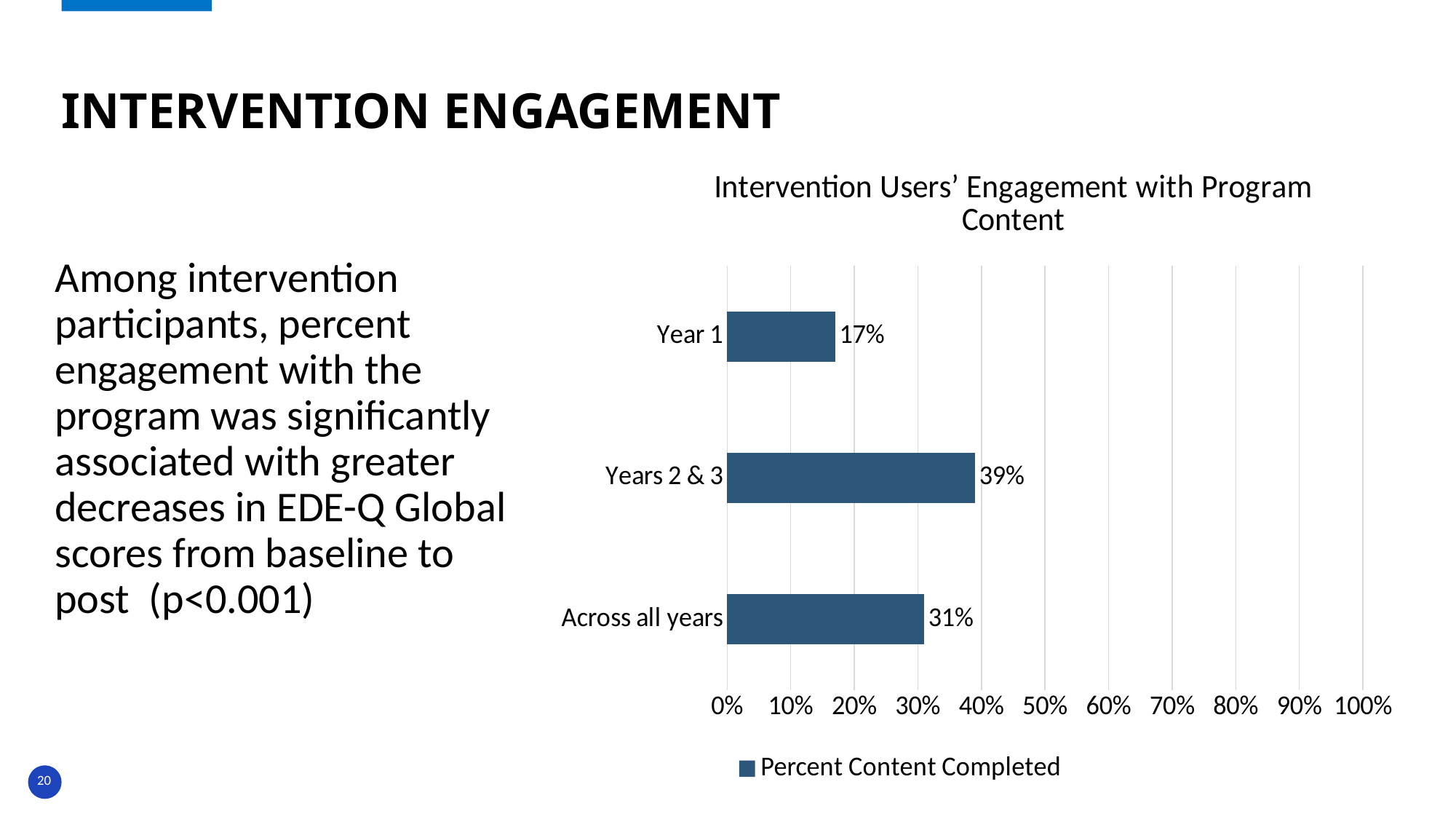
What is the Percent Content Completed for Years 2 & 3? 39% What kind of chart is shown on the slide? Bar chart What is the title of the chart? Intervention Users' Engagement with Program Content Which has a higher Percent Content Completed, Year 1 or Across all years? Across all years Is the value for Years 2 & 3 greater or less than 30%? greater What is the Percent Content Completed for Year 1? 17% Which category has the lowest Percent Content Completed? Year 1 How many categories are shown in the chart? 3 Which category has the highest Percent Content Completed? Years 2 & 3 What is the Percent Content Completed across all years? 31% What is the difference in Percent Content Completed between Years 2 & 3 and Year 1? 22% What is the difference in Percent Content Completed between Years 2 & 3 and Across all years? 8%